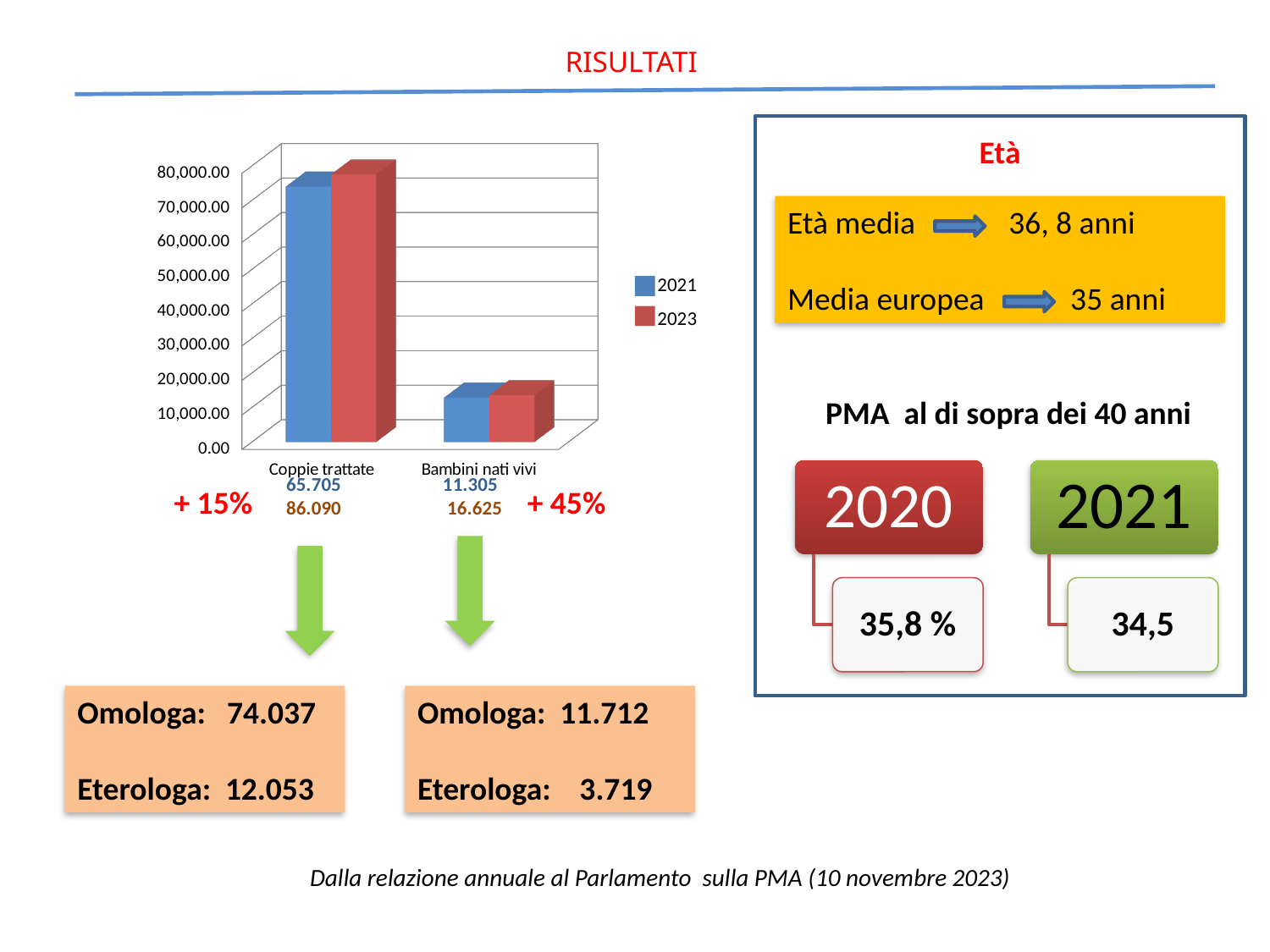
What value is printed for Coppie trattate in 2023? 86.090 How many categories are shown on the x axis of the chart? 2 What value is printed for Bambini nati vivi in 2021? 11.305 Which category has the lowest bar in the chart? Bambini nati vivi What value is printed for Coppie trattate in 2021? 65.705 Is the 2021 bar for Bambini nati vivi greater or less than 20,000.00? less Which category has the highest bar in the chart? Coppie trattate Is the 2023 bar for Coppie trattate greater or less than 70,000.00? greater What value is printed for Bambini nati vivi in 2023? 16.625 What type of chart is shown on the left of the slide? bar chart How many series does the chart legend list? 2 Which years are listed in the chart legend? 2021 and 2023